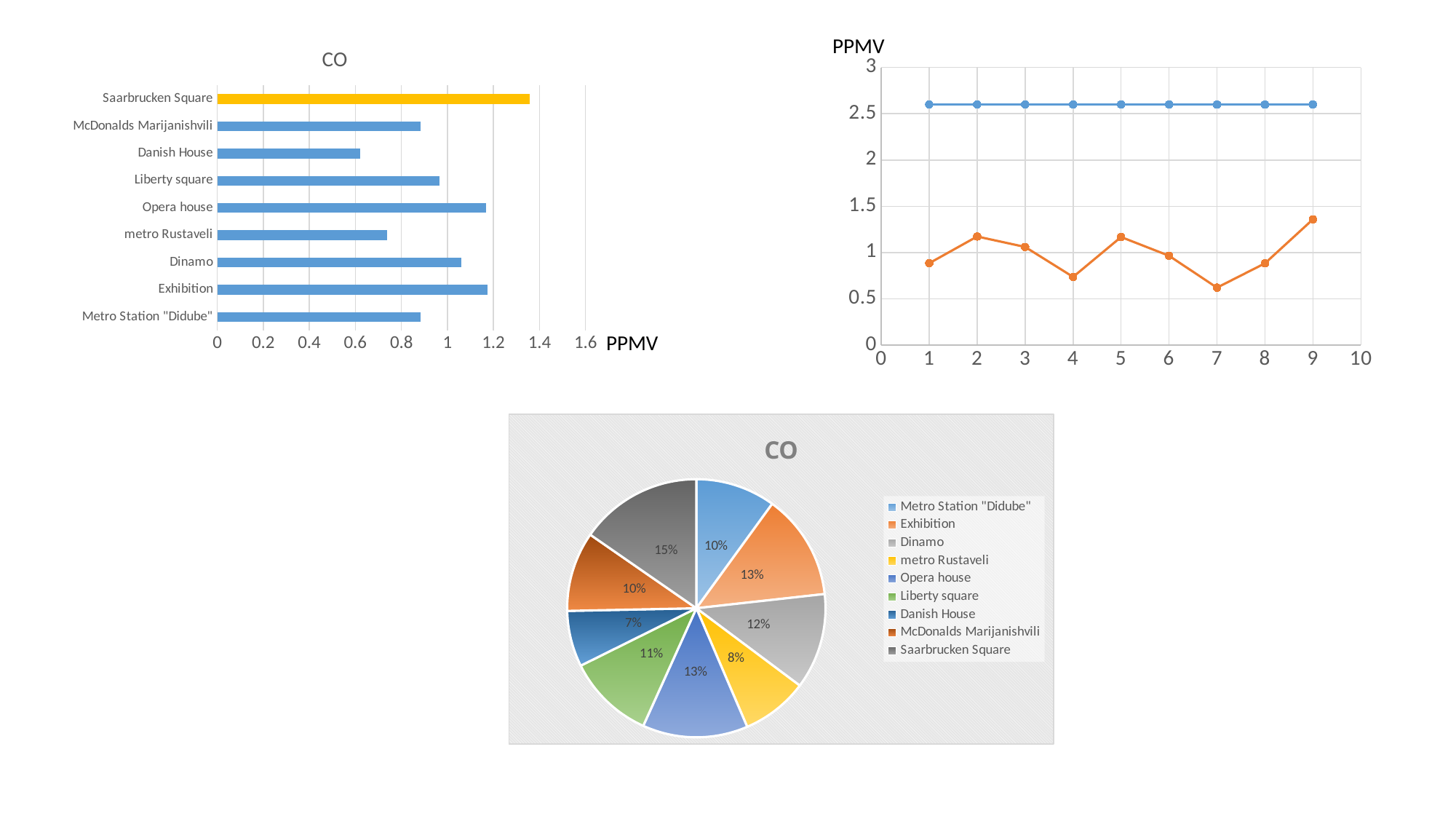
In the line chart at the top right, how many series are plotted? 2 In the bar chart titled CO at the top left, which location has the lowest value? Danish House In the bar chart titled CO at the top left, which bar is coloured differently from the others? Saarbrucken Square In the pie chart titled CO, what share does Saarbrucken Square have? 15% In the bar chart titled CO at the top left, is the value for Danish House greater or less than 0.8? less In the pie chart titled CO, which location has the smallest slice? Danish House In the bar chart titled CO at the top left, is the value for Saarbrucken Square greater or less than 1.2? greater In the bar chart titled CO at the top left, how many locations are shown? 9 In the line chart at the top right, at which x value does the orange series reach its highest point? 9 In the line chart at the top right, is the blue series greater or less than 2.5 across all points? greater What kind of chart is the chart at the top right of the slide? line chart In the bar chart titled CO at the top left, which location has the highest value? Saarbrucken Square